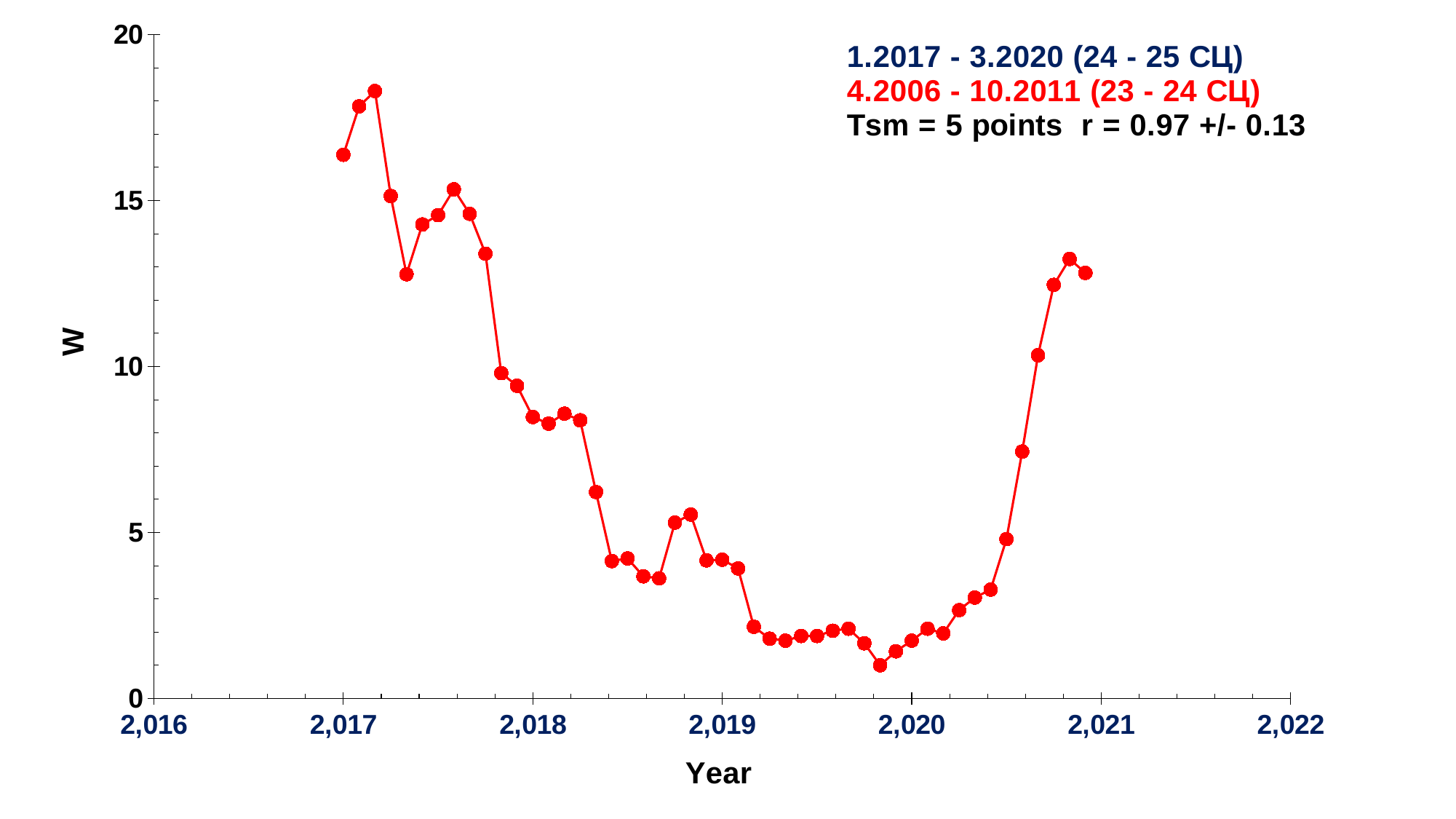
What is the label of the vertical axis? W Which is larger, the value of W at year 2017 or at year 2021? 2017 Is the value of W at the last plotted point (just after 2021) greater or less than 10? greater Is the value of W at year 2019 greater or less than 5? less Do the values of W rise or fall between 2020 and 2021? rise Is the value of W at year 2018 greater or less than 10? less What kind of chart is shown on the slide? line chart What correlation value r is stated on the slide? 0.97 +/- 0.13 Do the values of W rise or fall between 2017 and 2020? fall